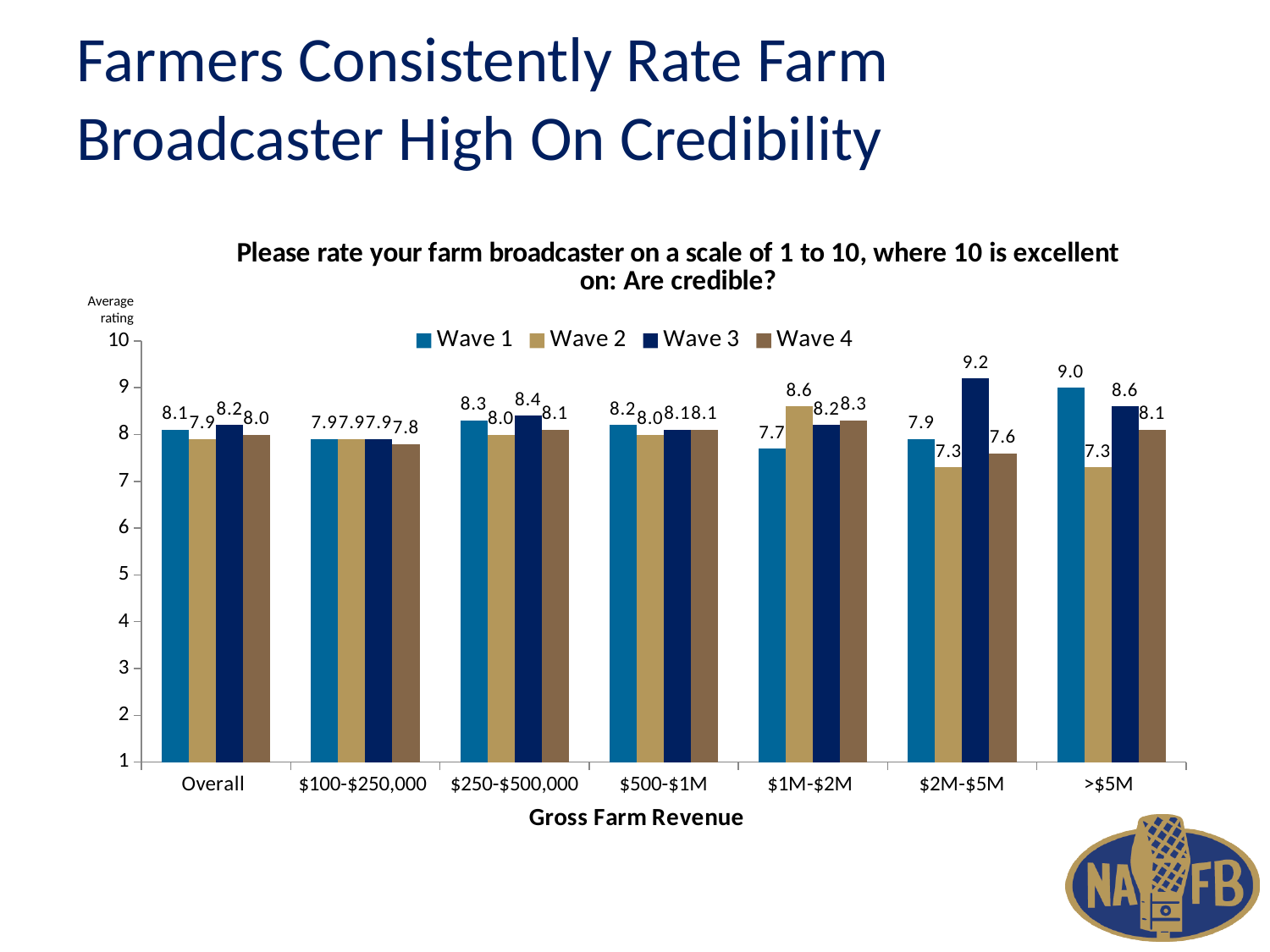
How many series does the legend list? 4 What is the Wave 3 average rating for the $2M-$5M gross farm revenue group? 9.2 What is the difference between the Wave 3 and Wave 2 ratings for the $2M-$5M group? 1.9 Which gross farm revenue group has the lowest Wave 1 rating? $1M-$2M What kind of chart is shown on the slide? Bar chart What is the Wave 1 average rating for the >$5M gross farm revenue group? 9.0 Which gross farm revenue group has the highest Wave 3 rating? $2M-$5M For the >$5M group, which is larger, the Wave 1 rating or the Wave 2 rating? Wave 1 Is the Wave 3 value for the $2M-$5M group greater or less than 9? greater What is the Wave 2 average rating for the Overall category? 7.9 How many gross farm revenue categories are shown on the x axis? 7 What is the Wave 4 average rating for the $1M-$2M group? 8.3